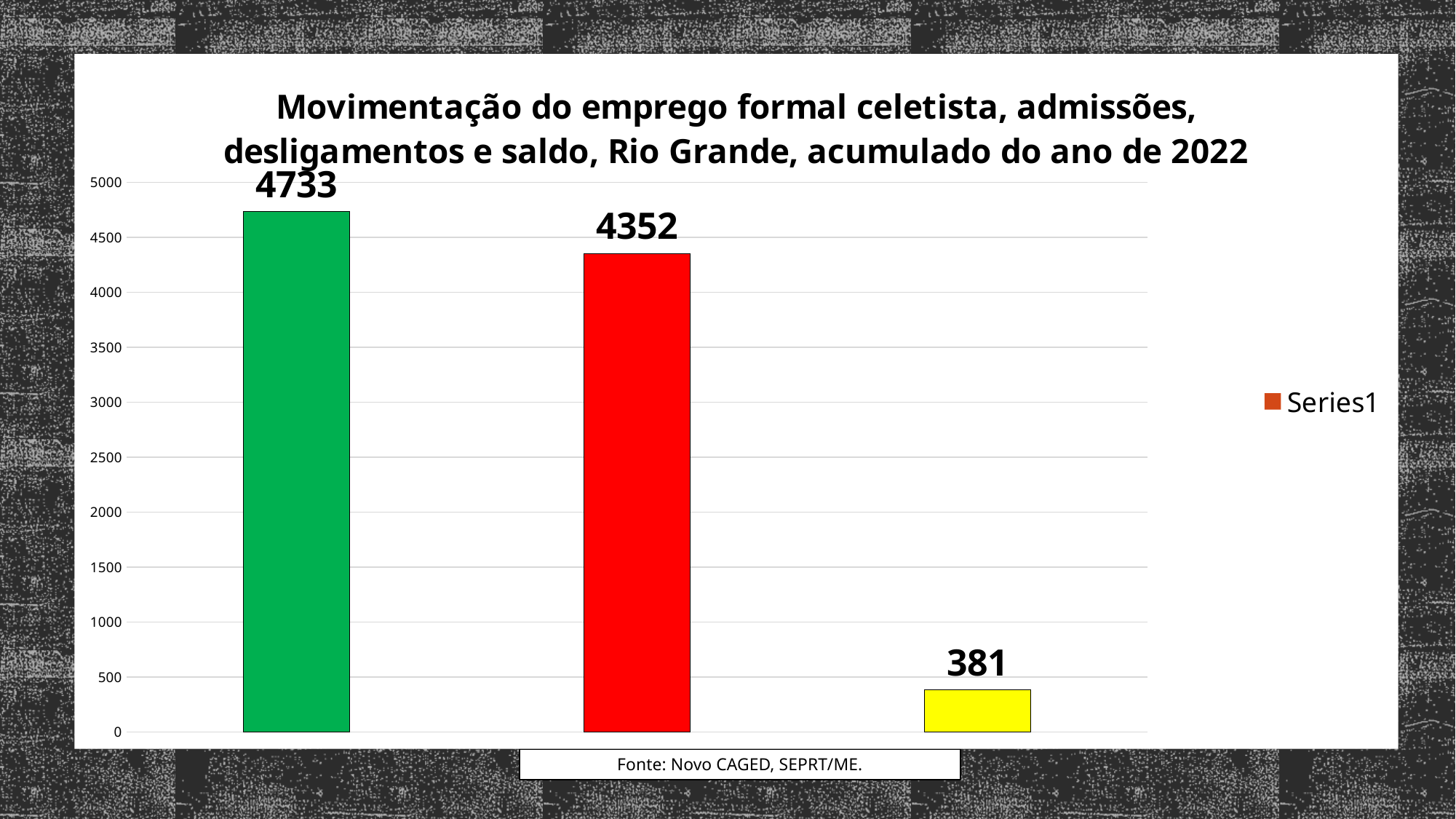
What value is shown on the yellow bar? 381 Is the value of the yellow bar greater or less than 500? less What is the difference between the red bar's value and the yellow bar's value? 3971 Which bar has the lowest value: the green, red or yellow bar? yellow What value is shown on the green bar? 4733 Which bar has the highest value: the green, red or yellow bar? green What is the difference between the green bar's value and the red bar's value? 381 What value is shown on the red bar? 4352 What kind of chart is shown on the slide? bar chart What is the name of the series listed in the legend? Series1 Which is larger, the value of the green bar or the value of the red bar? green bar How many bars are plotted in the chart? 3